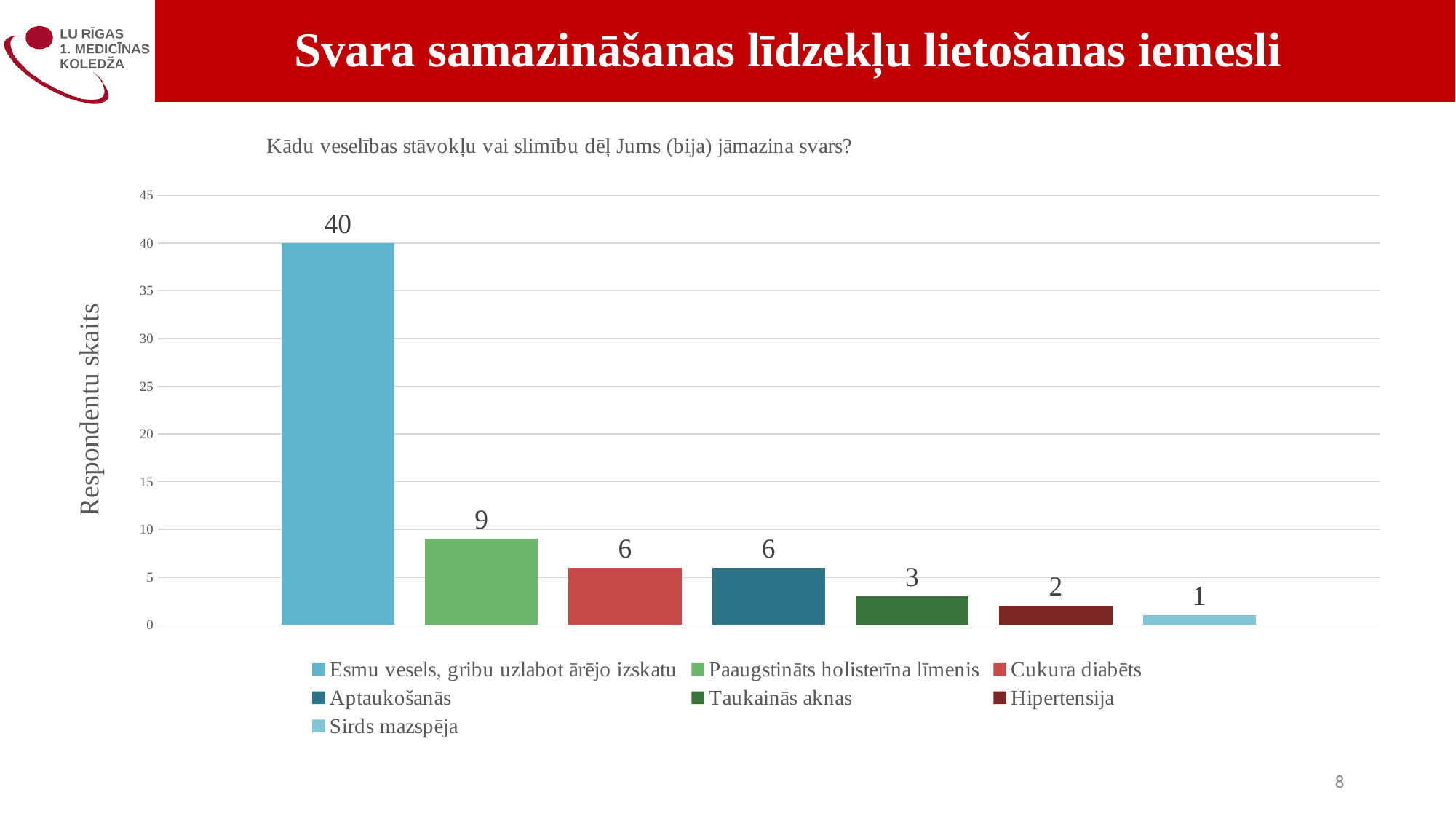
What is the difference between the values for "Esmu vesels, gribu uzlabot ārējo izskatu" and "Paaugstināts holisterīna līmenis"? 31 How many categories are shown in the chart? 7 Is the value for "Esmu vesels, gribu uzlabot ārējo izskatu" greater or less than 35? greater What is the value for "Hipertensija"? 2 What kind of chart is shown on the slide? bar chart What is the value for "Paaugstināts holisterīna līmenis"? 9 What is the label of the vertical axis? Respondentu skaits Which category has the highest number of respondents? Esmu vesels, gribu uzlabot ārējo izskatu How many respondents chose "Esmu vesels, gribu uzlabot ārējo izskatu"? 40 Which is larger, the value for "Paaugstināts holisterīna līmenis" or the value for "Cukura diabēts"? Paaugstināts holisterīna līmenis What is the difference between the values for "Taukainās aknas" and "Sirds mazspēja"? 2 Which category has the lowest number of respondents? Sirds mazspēja